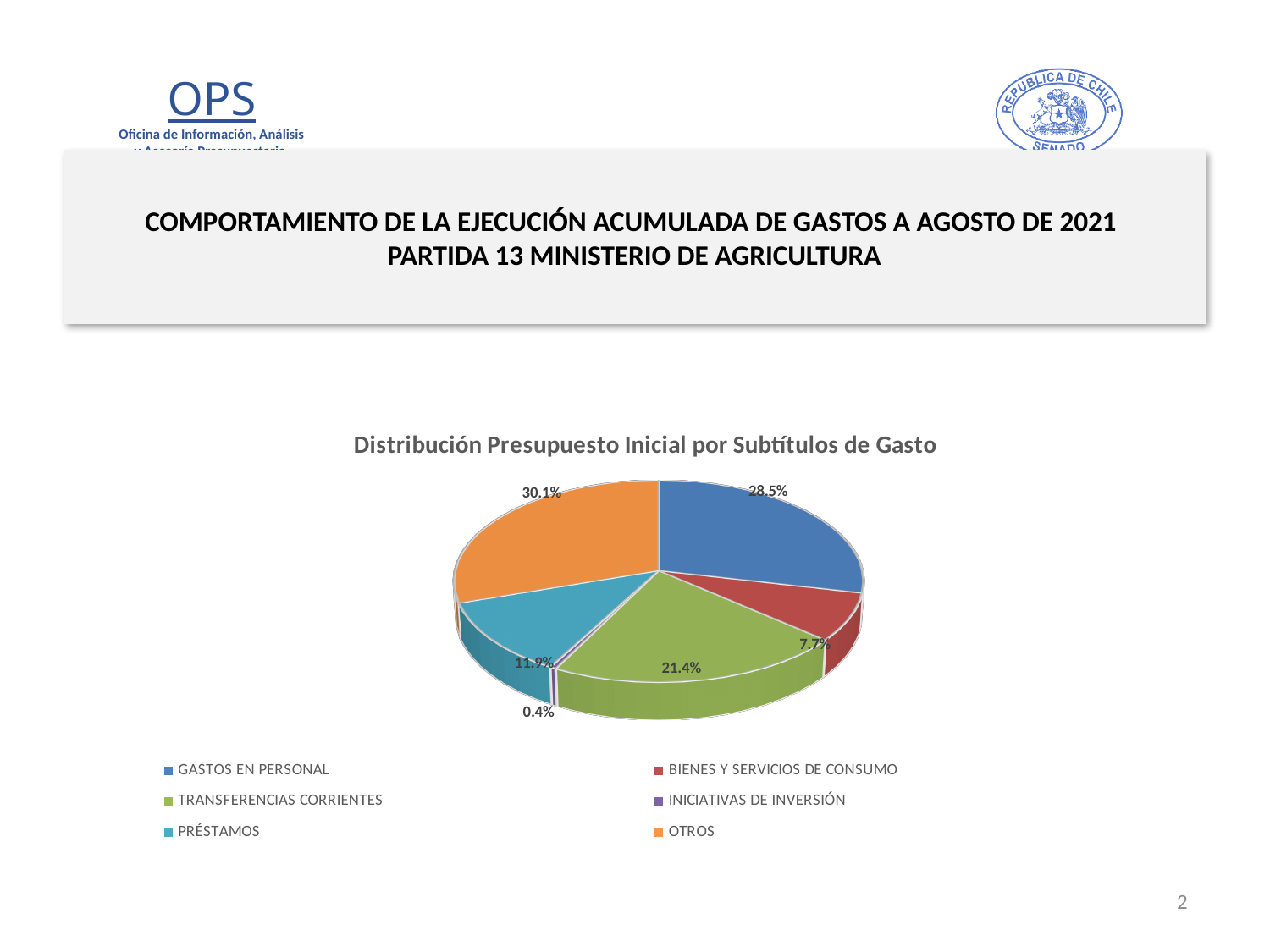
What share of the pie does PRÉSTAMOS represent? 11.9% What kind of chart is shown on the slide? Pie chart How many categories does the legend list? 6 What is the title of the chart? Distribución Presupuesto Inicial por Subtítulos de Gasto Which category has the smallest slice of the pie? INICIATIVAS DE INVERSIÓN What share of the pie does GASTOS EN PERSONAL represent? 28.5% Which is larger, the share for TRANSFERENCIAS CORRIENTES or the share for PRÉSTAMOS? TRANSFERENCIAS CORRIENTES What share of the pie does BIENES Y SERVICIOS DE CONSUMO represent? 7.7% What share of the pie does TRANSFERENCIAS CORRIENTES represent? 21.4% What is the difference in percentage points between OTROS and GASTOS EN PERSONAL? 1.6 Which category has the largest slice of the pie? OTROS What colour is the slice for OTROS? Orange